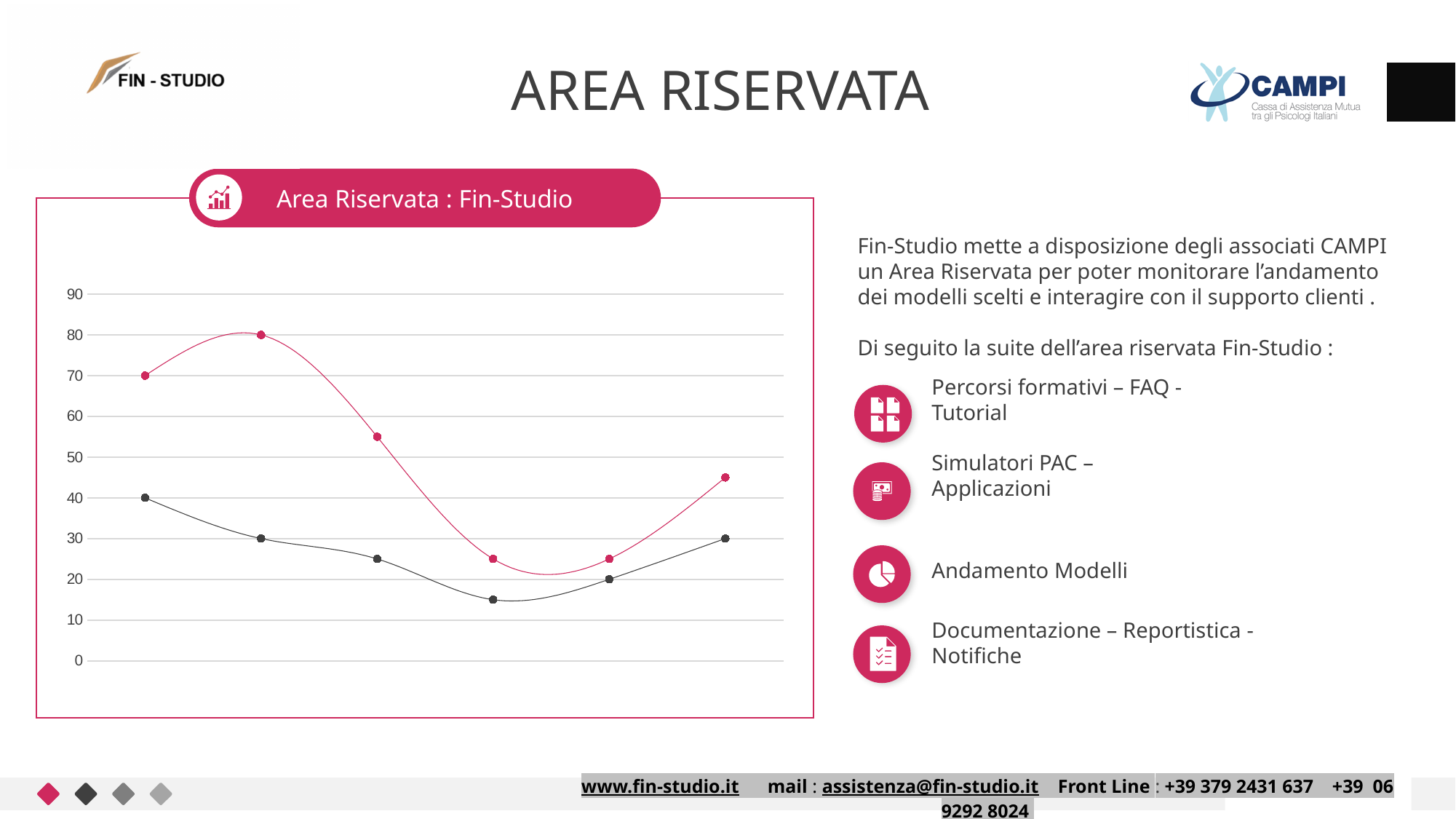
Is the value of the third point on the pink line greater or less than 50? greater What is the value of the first point on the pink line? 70 Which point on the black line has the lowest value? the fourth point What is the value of the fifth point on the black line? 20 What is the value of the first point on the black line? 40 How many lines are plotted in the chart? 2 What is the difference between the pink line and the black line at the first point? 30 What kind of chart is shown on the slide? line chart At the first point, which line has the larger value, the pink line or the black line? the pink line What is the value of the second point on the pink line? 80 Which point on the pink line has the highest value? the second point How many data points does each line in the chart have? 6